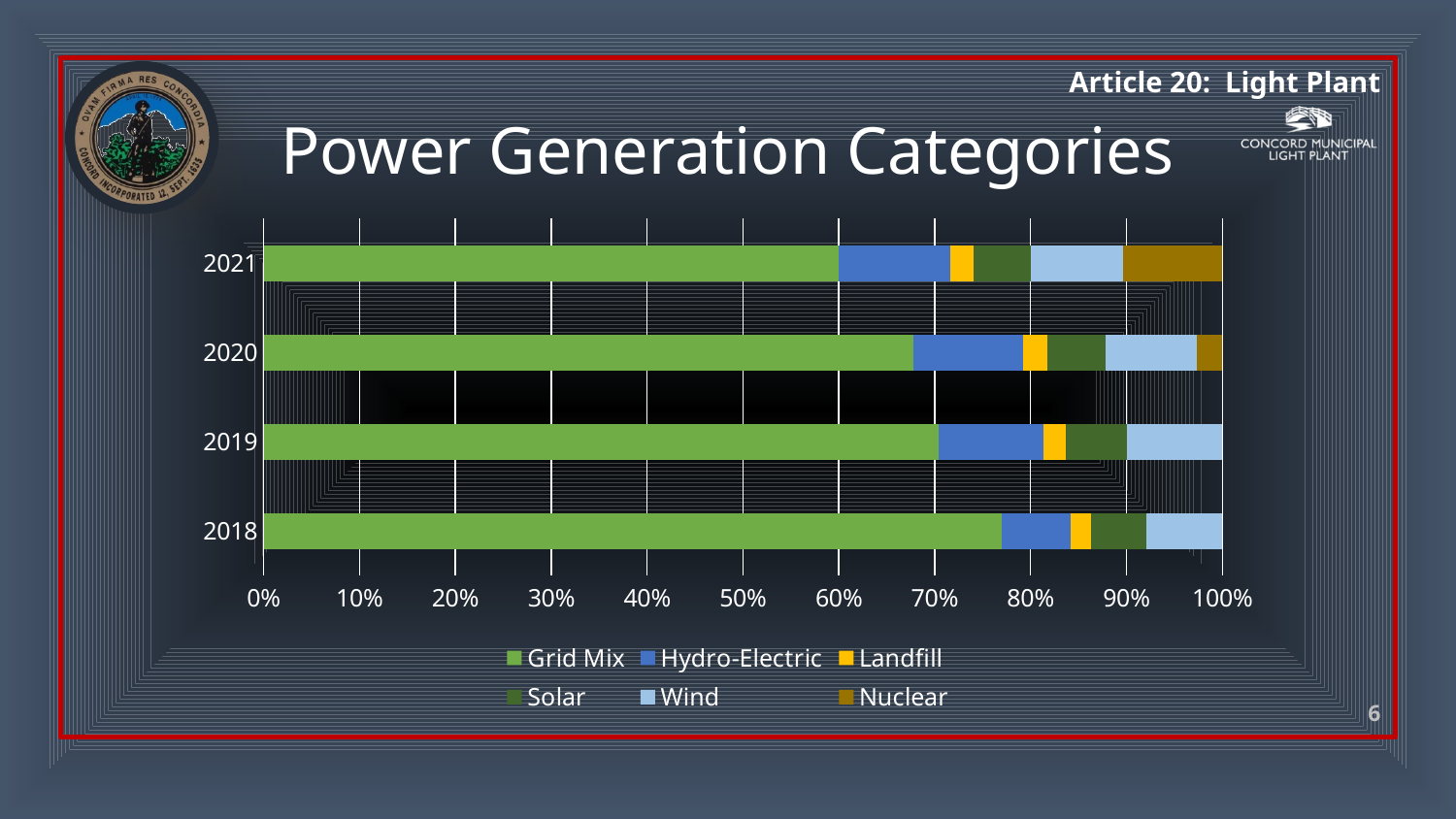
Is the Grid Mix share for 2018 greater or less than 70%? greater Which series is shown in yellow in the legend? Landfill Which year has the smallest Grid Mix share? 2021 Does the Grid Mix share rise or fall from 2018 to 2021? fall Which year has the largest Grid Mix share? 2018 How many series does the legend list? 6 How many years are shown on the chart? 4 What is the title of the chart? Power Generation Categories Is the Grid Mix share for 2020 greater or less than 70%? less Which year has the larger Grid Mix share, 2018 or 2021? 2018 Is the Grid Mix share for 2021 greater or less than 70%? less What kind of chart is shown on the slide? Stacked bar chart